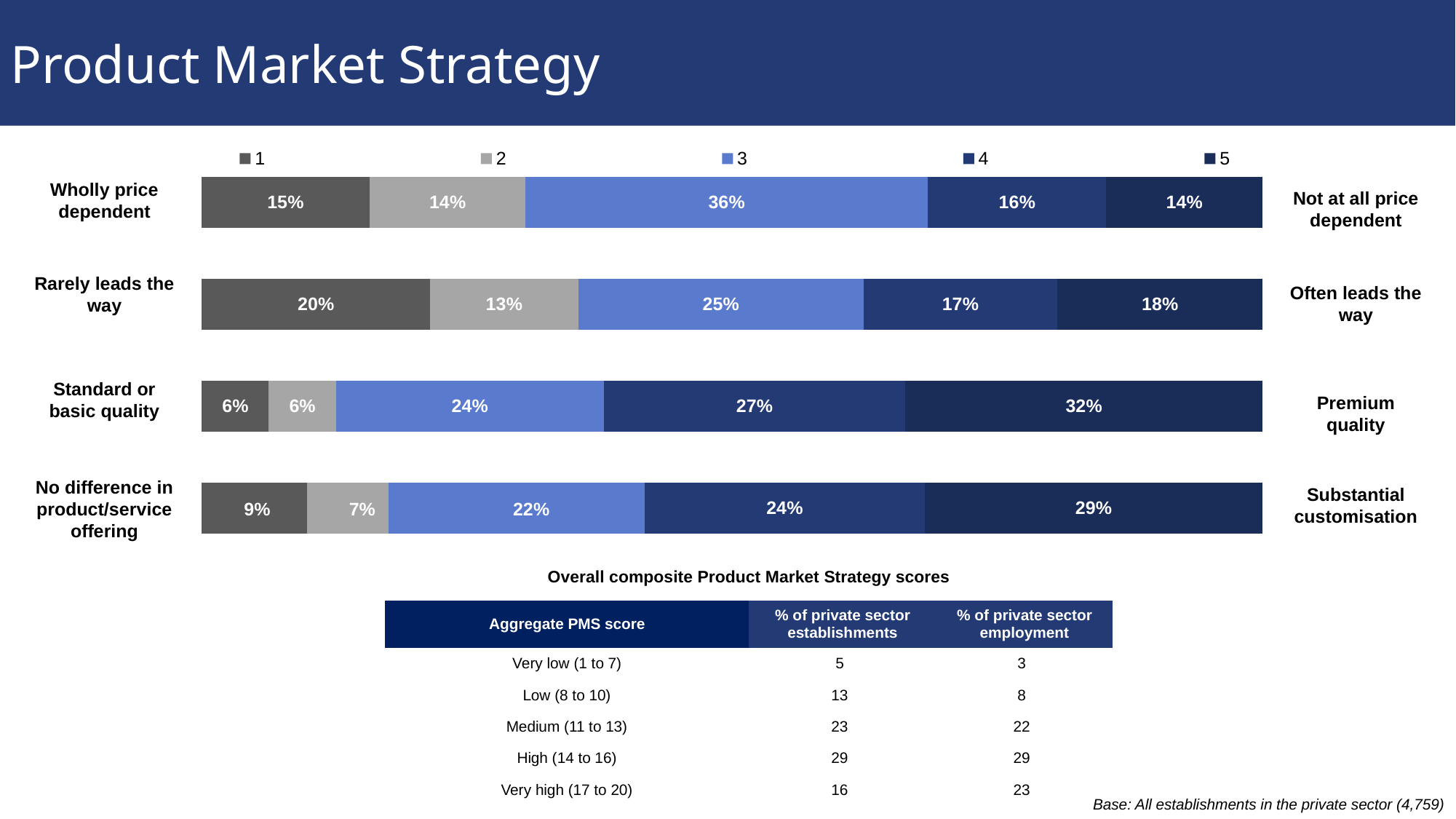
How many bars (rows) are plotted in the chart? 4 What is the total of the series 4 and series 5 values in the 'No difference in product/service offering' to 'Substantial customisation' bar? 53% What kind of chart is shown on the slide? Stacked bar chart What is the difference between the series 5 and series 1 values in the 'Standard or basic quality' to 'Premium quality' bar? 26% Which series has the highest value in the 'Rarely leads the way' to 'Often leads the way' bar? 3 Which is larger: the series 4 value in the 'Wholly price dependent' bar or the series 4 value in the 'Standard or basic quality' bar? Standard or basic quality What is the value for series 1 in the 'Rarely leads the way' to 'Often leads the way' bar? 20% Which series has the lowest value in the 'No difference in product/service offering' to 'Substantial customisation' bar? 2 How many series does the chart legend list? 5 What is the value for series 2 in the 'No difference in product/service offering' to 'Substantial customisation' bar? 7% What is the value for series 5 in the 'Standard or basic quality' to 'Premium quality' bar? 32% What is the value for series 3 in the 'Wholly price dependent' to 'Not at all price dependent' bar? 36%